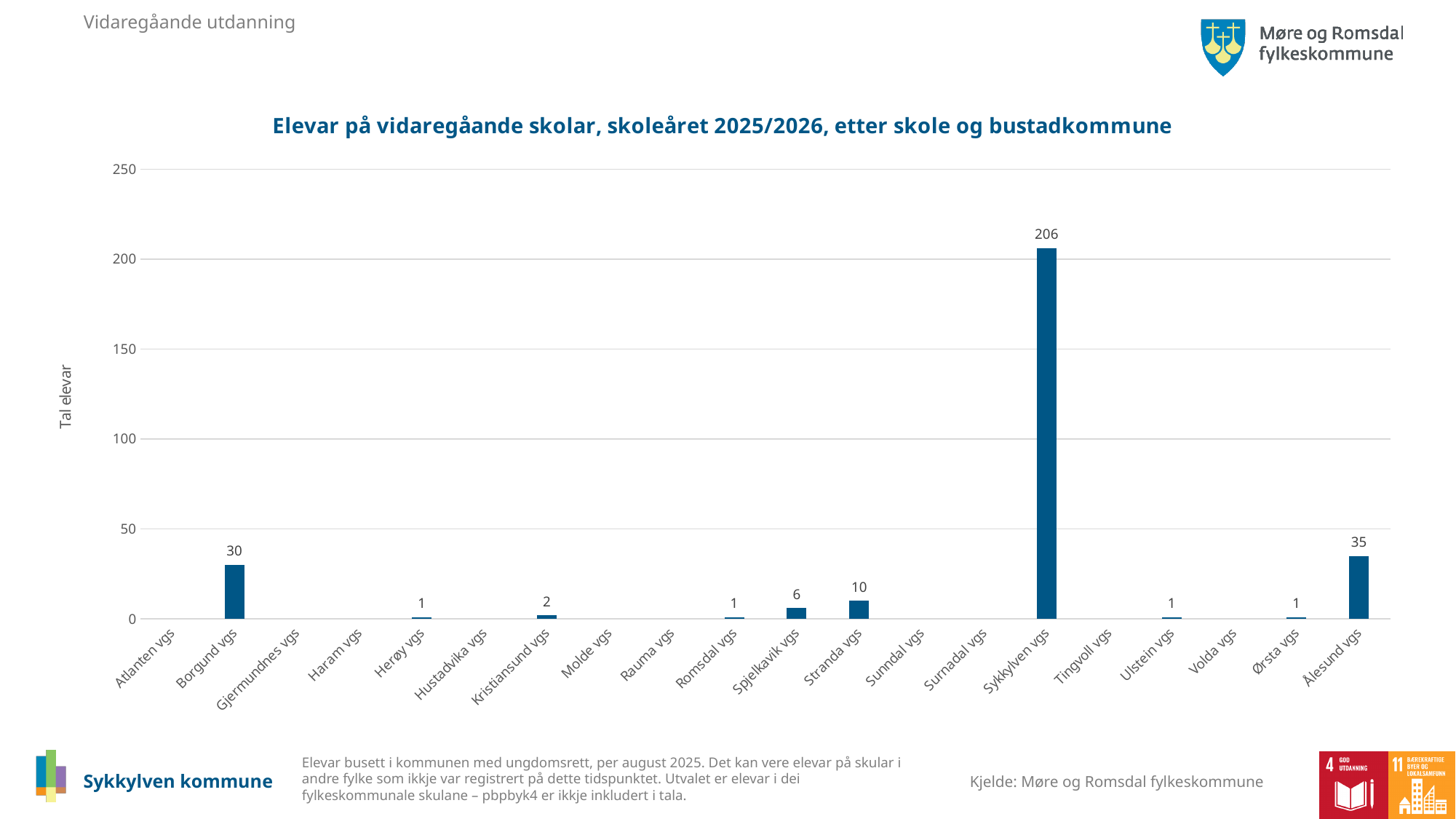
What is the value for Sykkylven vgs? 206 What is the value for Ålesund vgs? 35 What is the difference between the values for Ålesund vgs and Borgund vgs? 5 What kind of chart is shown on the slide? bar chart Which school has the highest number of pupils? Sykkylven vgs Which is larger, the value for Stranda vgs or the value for Spjelkavik vgs? Stranda vgs What is the value for Stranda vgs? 10 What is the difference between the values for Sykkylven vgs and Ålesund vgs? 171 What is the value for Borgund vgs? 30 What is the value for Spjelkavik vgs? 6 Is the value for Sykkylven vgs greater or less than 200? greater How many schools are listed on the x axis? 20